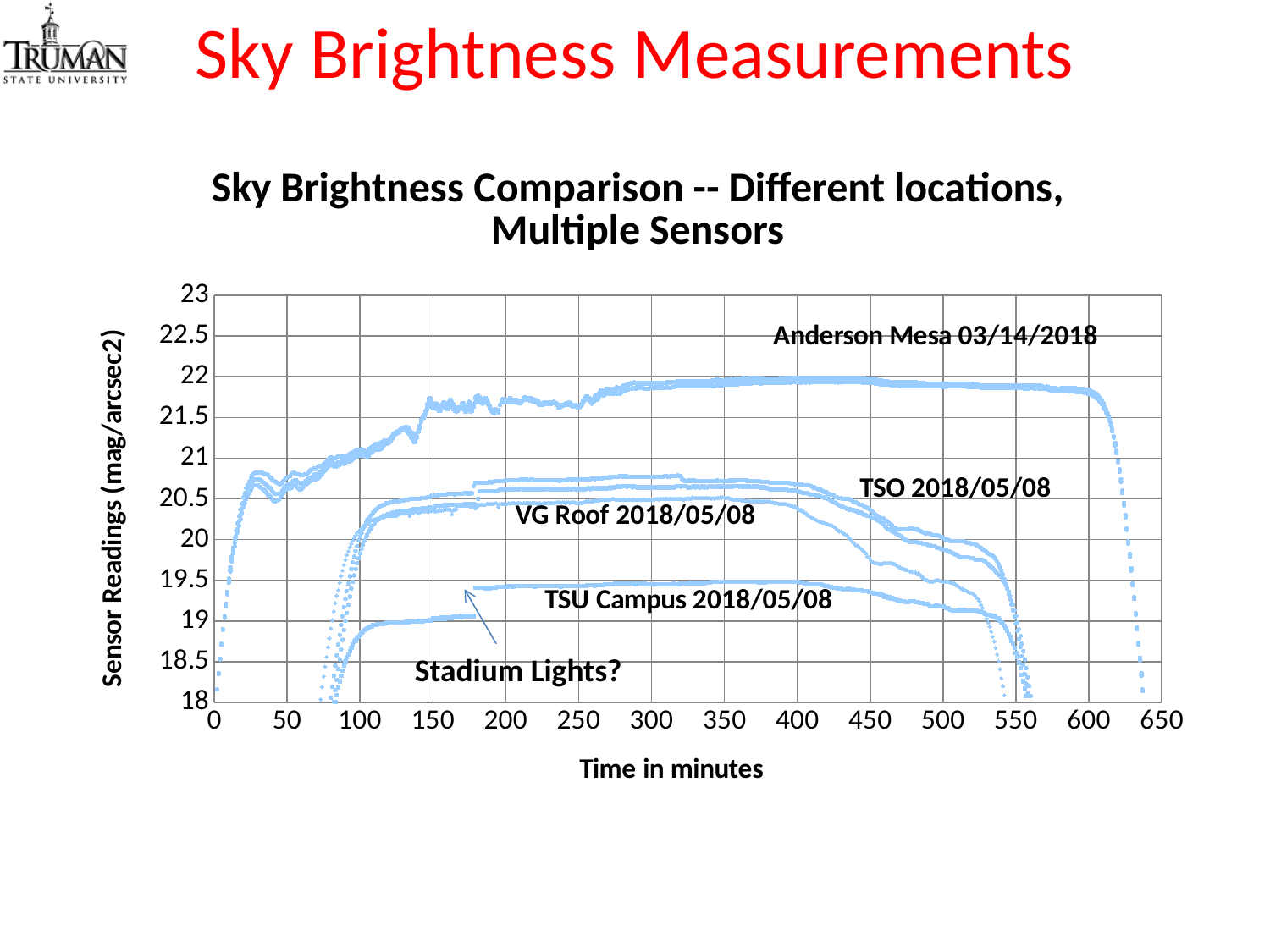
At 300 minutes, which has the larger sensor reading: TSO 2018/05/08 or TSU Campus 2018/05/08? TSO 2018/05/08 Do the TSO 2018/05/08 readings rise or fall between 450 and 550 minutes? fall Which location has the lowest sensor readings on the chart? TSU Campus 2018/05/08 Is the Anderson Mesa 03/14/2018 reading at 400 minutes greater or less than 21.5? greater What is the title of the chart? Sky Brightness Comparison -- Different locations, Multiple Sensors Is the TSU Campus 2018/05/08 reading at 300 minutes greater or less than 20? less How many labeled measurement locations are plotted on the chart? 4 What kind of chart is shown on the slide? scatter chart What is the label of the x axis? Time in minutes Which location has the highest sensor readings on the chart? Anderson Mesa 03/14/2018 Do the Anderson Mesa 03/14/2018 readings rise or fall between 0 and 300 minutes? rise Is the VG Roof 2018/05/08 reading at 200 minutes greater or less than 20? greater